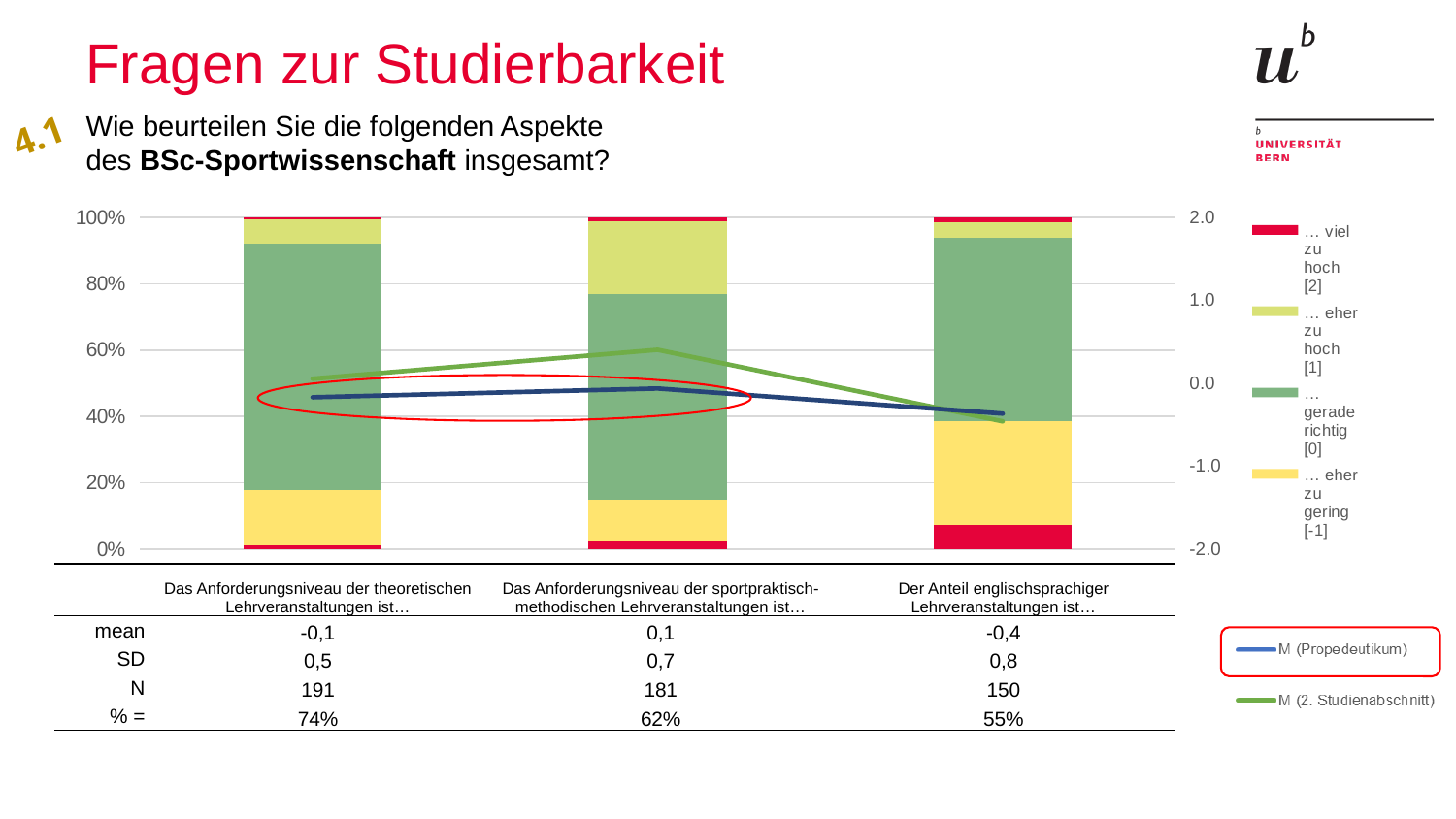
According to the table below the chart, what is N for 'Der Anteil englischsprachiger Lehrveranstaltungen ist…'? 150 How many entries does the legend on the right of the chart list? 4 On the right-hand axis, is the value of the M (2. Studienabschnitt) line for 'Das Anforderungsniveau der sportpraktisch-methodischen Lehrveranstaltungen ist…' greater or less than 0.0? greater Does the M (2. Studienabschnitt) line rise or fall from the second category to the third category? fall According to the table below the chart, what is the mean for 'Das Anforderungsniveau der sportpraktisch-methodischen Lehrveranstaltungen ist…'? 0,1 Which category has the lowest mean in the table below the chart? Der Anteil englischsprachiger Lehrveranstaltungen ist… What kind of chart is shown on the slide? combination bar and line chart (stacked bars with lines) Which category has the highest N in the table below the chart? Das Anforderungsniveau der theoretischen Lehrveranstaltungen ist… What is the difference in N between 'Das Anforderungsniveau der theoretischen Lehrveranstaltungen ist…' and 'Der Anteil englischsprachiger Lehrveranstaltungen ist…'? 41 How many categories are shown along the x axis of the chart? 3 Which legend entry is shown in red? … viel zu hoch [2] Which has the larger SD in the table: the sportpraktisch-methodischen category or the englischsprachiger category? Der Anteil englischsprachiger Lehrveranstaltungen ist…